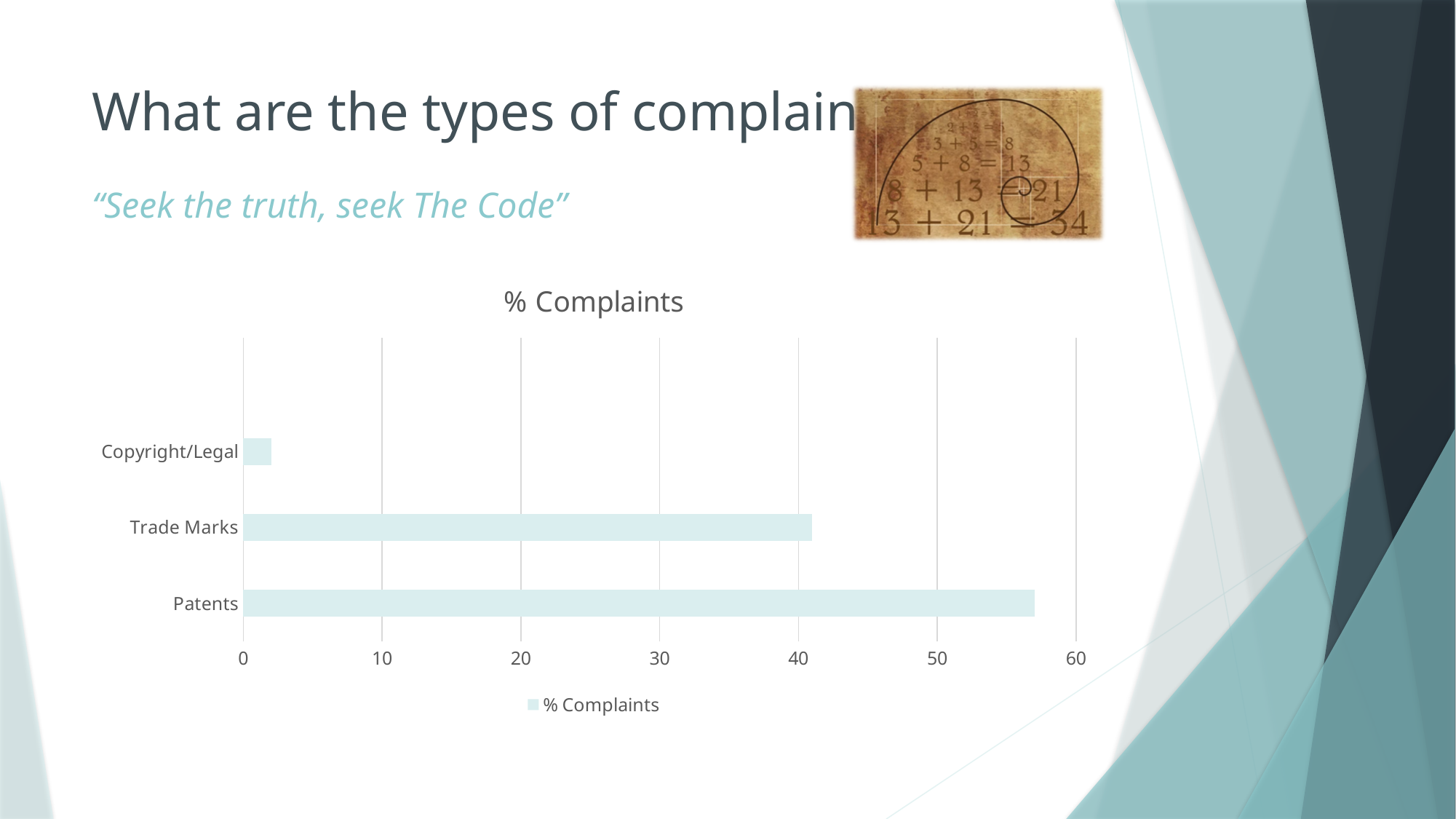
What is the name of the series shown in the legend? % Complaints Is the value for Trade Marks greater or less than 50? less Which category has the lowest value? Copyright/Legal Which is larger, the value for Trade Marks or the value for Patents? Patents Is the value for Patents greater or less than 50? greater How many categories are shown in the chart? 3 Which category has the highest value? Patents Is the value for Copyright/Legal greater or less than 10? less How many series does the legend list? 1 What type of chart is shown on the slide? bar chart What is the title of the chart? % Complaints